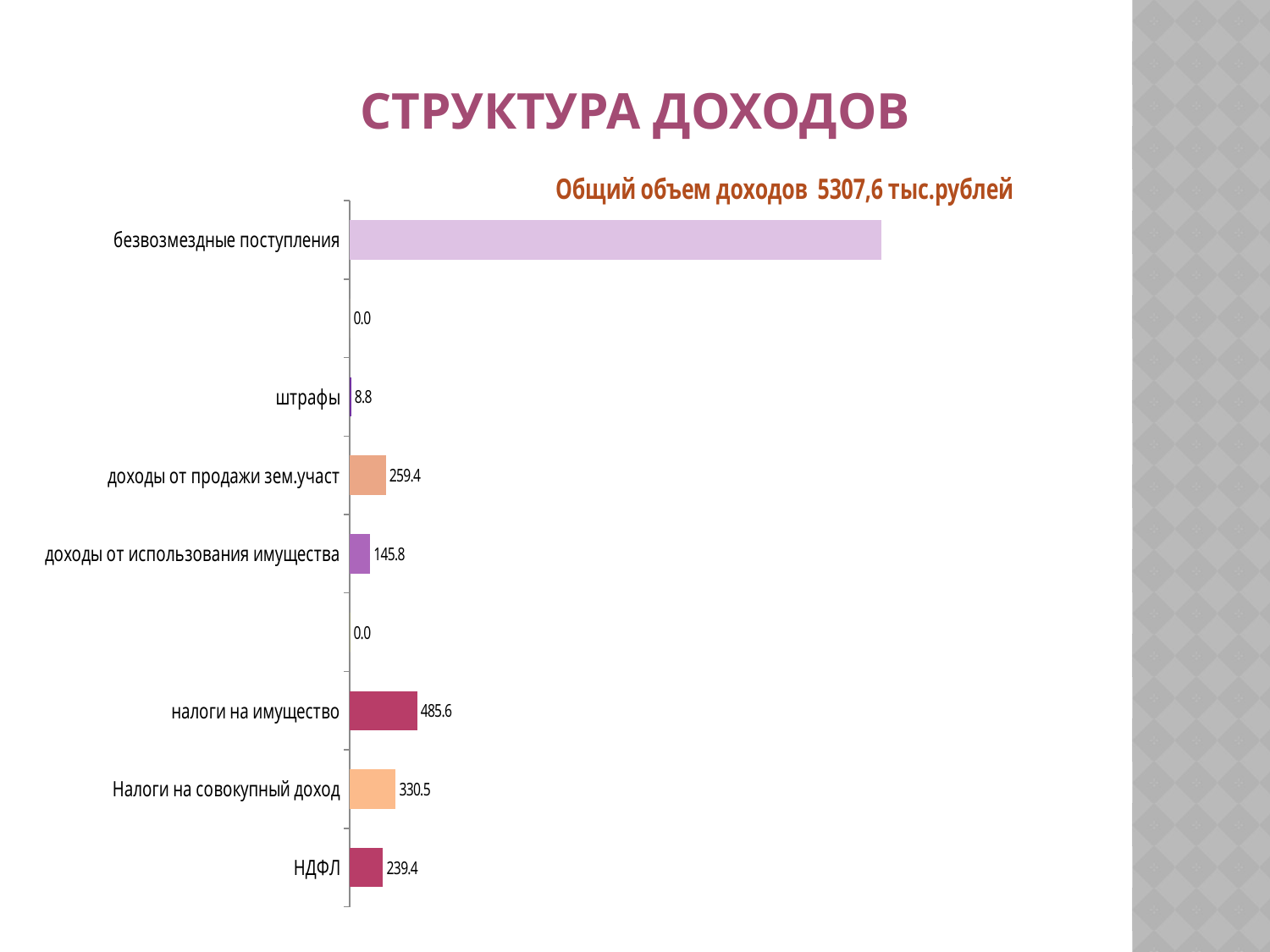
What is the value for Налоги на совокупный доход? 330.5 What total income amount is stated above the chart? 5307,6 тыс.рублей What is the value for штрафы? 8.8 What is the value for НДФЛ? 239.4 What is the difference between налоги на имущество and Налоги на совокупный доход? 155.1 Which labelled category has the smallest non-zero value? штрафы What kind of chart is shown on the slide? bar chart What is the value for налоги на имущество? 485.6 Which is larger, доходы от продажи зем.участ or доходы от использования имущества? доходы от продажи зем.участ What is the difference between доходы от продажи зем.участ and НДФЛ? 20.0 What is the value for доходы от использования имущества? 145.8 Which category has the largest bar? безвозмездные поступления